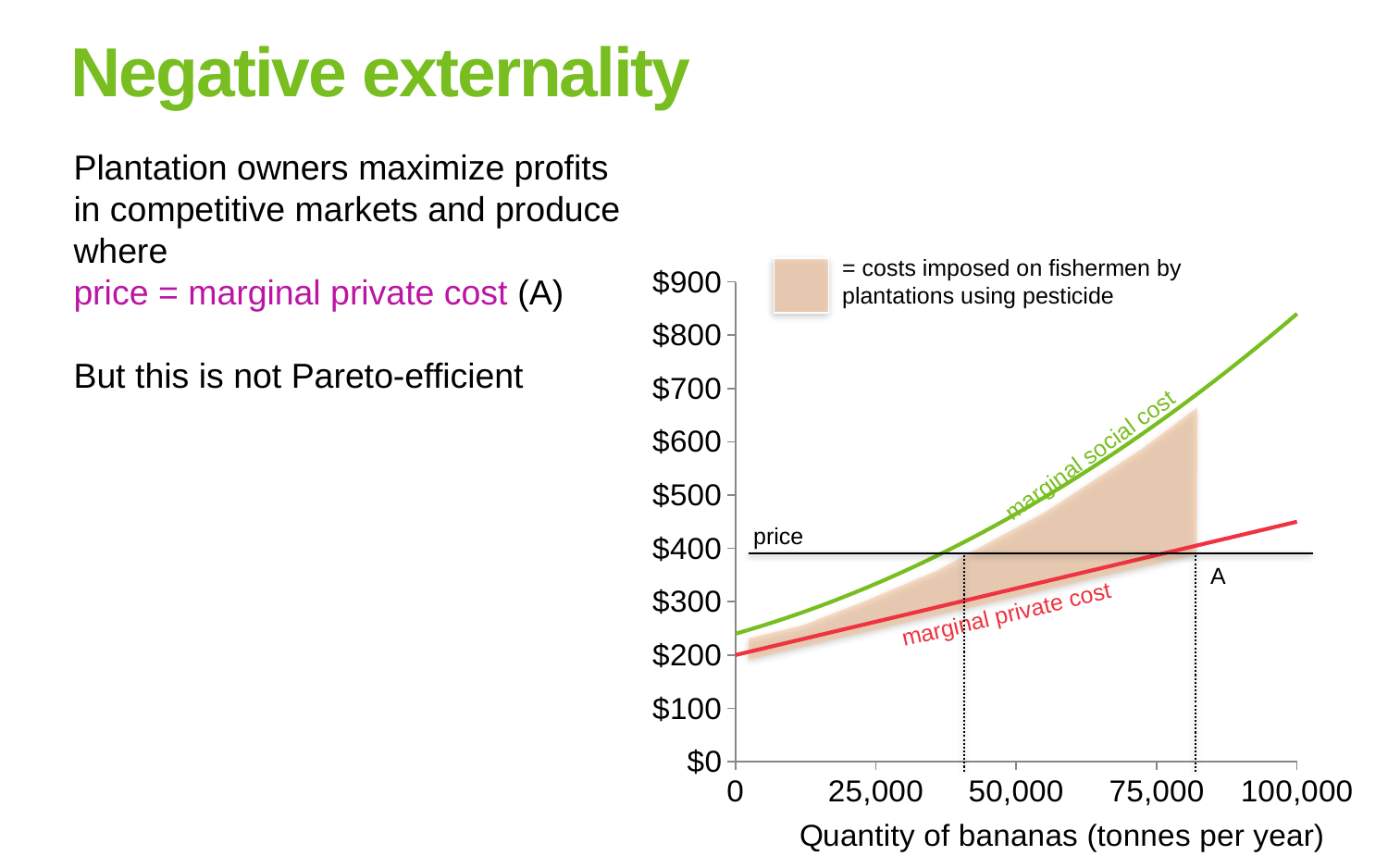
What kind of chart is shown on the slide? line chart Is the marginal private cost at a quantity of 100,000 greater or less than $500? less Is the price line greater or less than $300? greater What does the shaded area in the chart represent, according to the legend? costs imposed on fishermen by plantations using pesticide Is the marginal social cost at a quantity of 100,000 greater or less than $700? greater Does the marginal private cost curve rise or fall as the quantity of bananas increases? rise At a quantity of 75,000, which is higher: marginal social cost or marginal private cost? marginal social cost Does the marginal social cost curve rise or fall as the quantity of bananas increases? rise What is the title of the x axis? Quantity of bananas (tonnes per year)